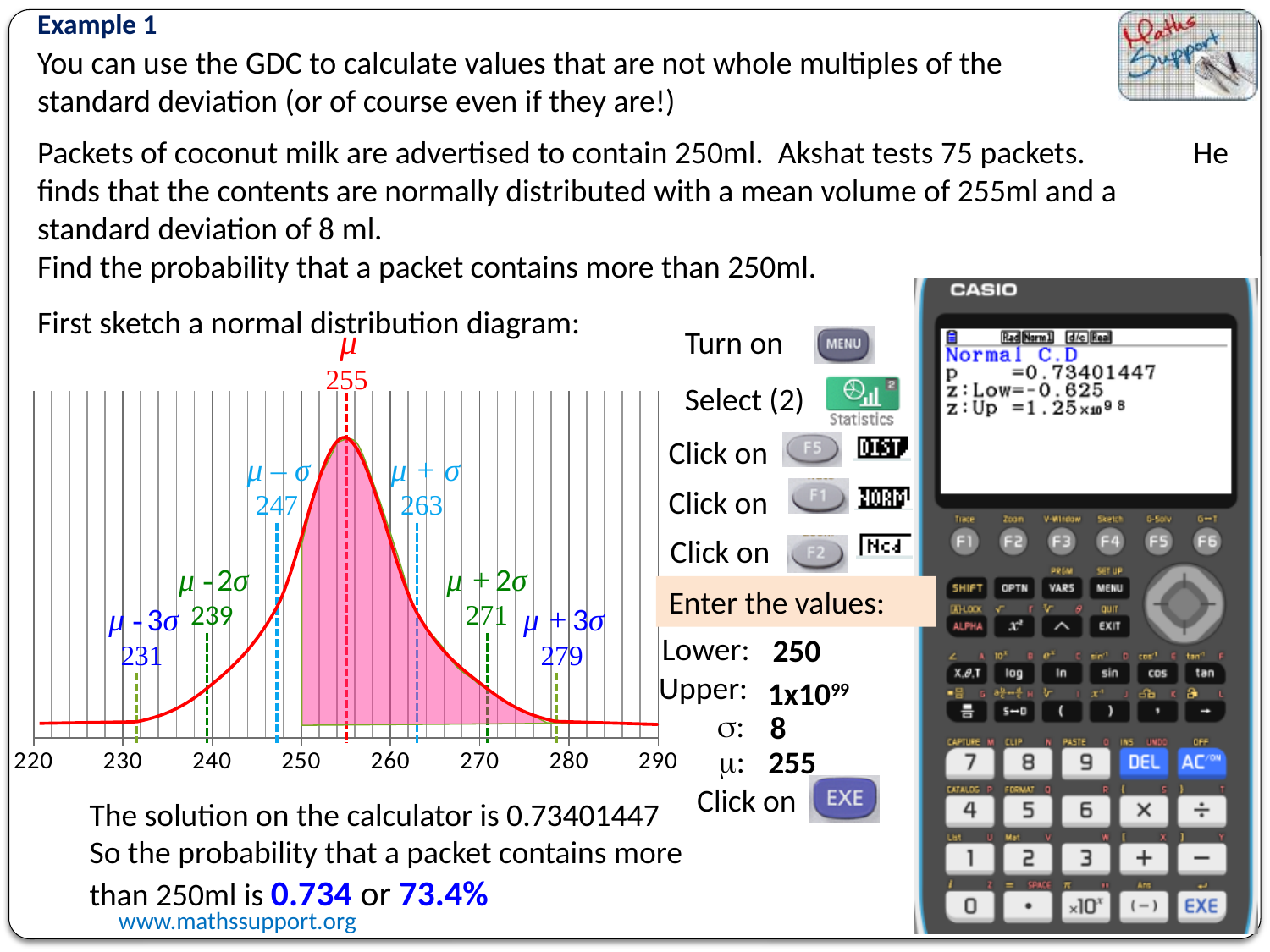
What value is labelled at μ + σ on the diagram? 263 What is the difference between the values labelled at μ + 3σ and μ? 24 How does the curve behave as x increases from 220 to 290? It rises to a peak at 255 and then falls What value is labelled at the mean μ on the normal distribution diagram? 255 What value is labelled at μ + 3σ on the diagram? 279 What value is labelled at μ − 2σ on the diagram? 239 What kind of chart is shown on the slide? A normal distribution curve Is the curve higher at 255 or at 270 on the diagram? 255 How many labelled positions (μ and the σ multiples) are marked with dashed lines on the diagram? 7 What value is labelled at μ − σ on the diagram? 247 What is the difference between the values labelled at μ + σ and μ − σ? 16 What colour is the shaded region under the curve? Pink